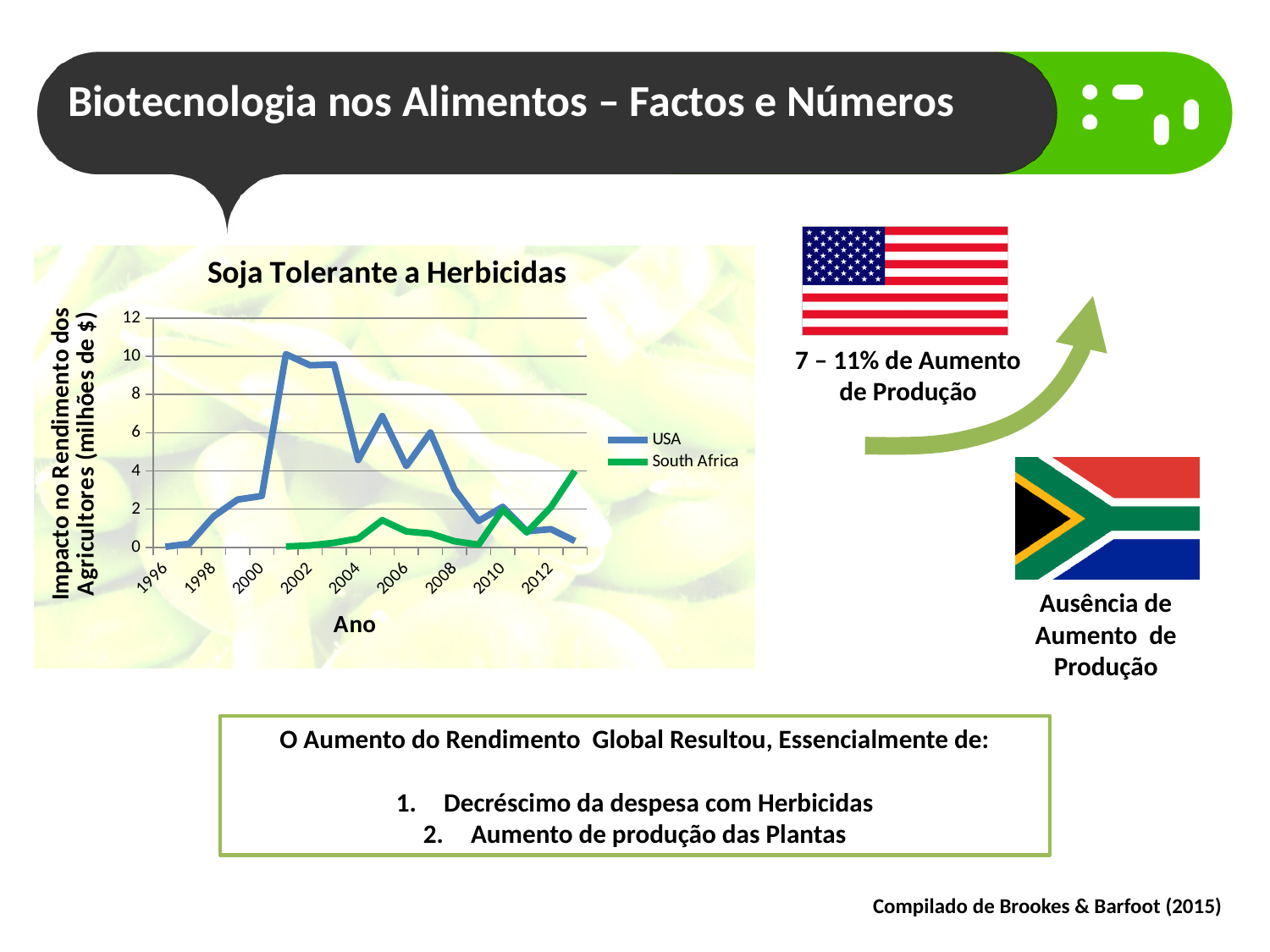
Is the value for USA in 1996 greater or less than 2? less How many series does the legend of the chart list? 2 Does the South Africa line rise or fall between 2011 and 2013? rise What kind of chart is shown on the slide? line chart Is the value for South Africa in 2013 greater or less than 2? greater Which series reaches the highest value on the chart? USA In 2001, which series has the larger value, USA or South Africa? USA Is the value for South Africa in 2005 greater or less than 4? less What is the title of the chart? Soja Tolerante a Herbicidas In 2013, which series has the larger value, USA or South Africa? South Africa Which two series are listed in the chart legend? USA and South Africa